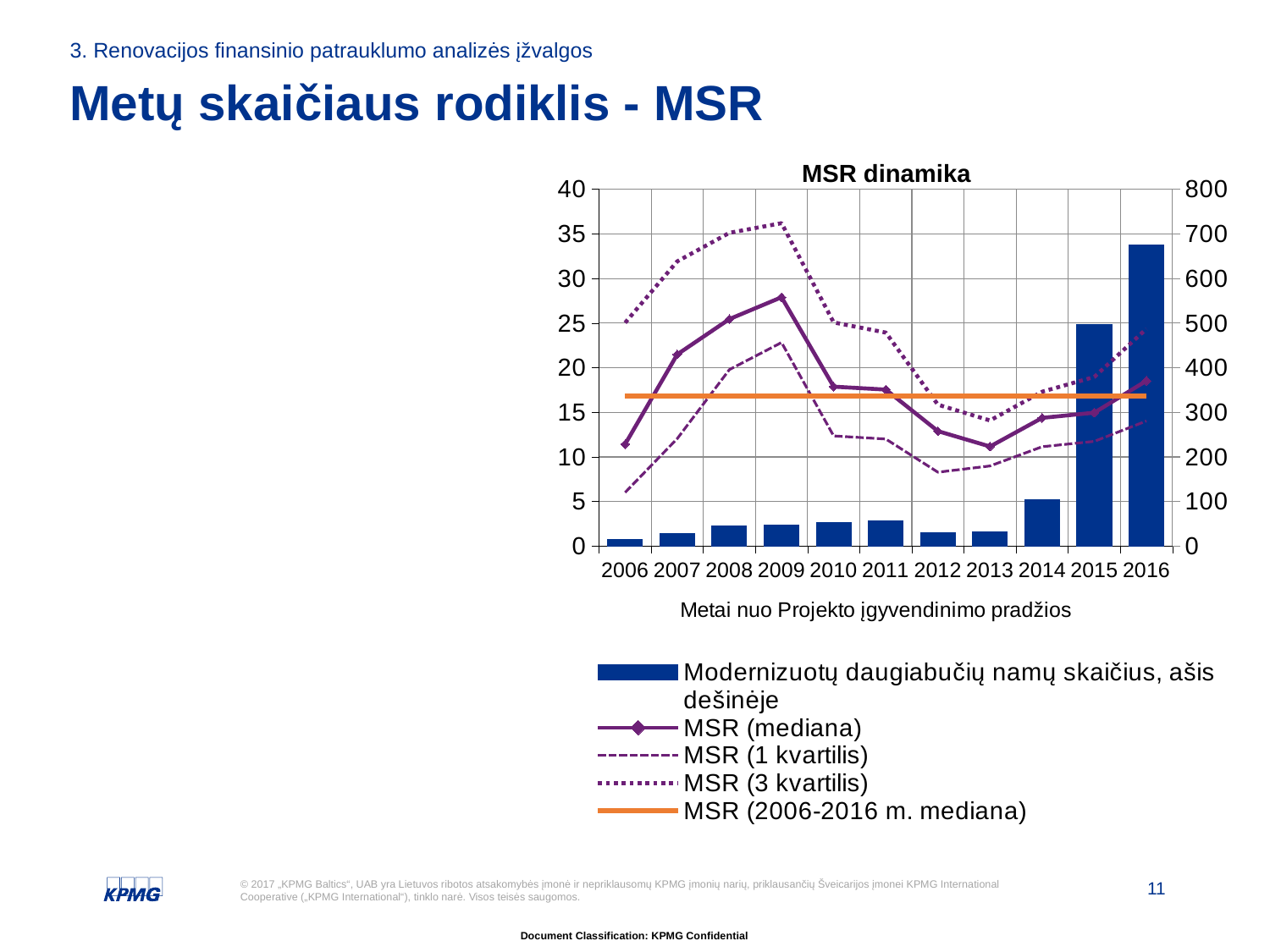
How many series does the legend of the MSR dinamika chart list? 5 Is the MSR (1 kvartilis) value for 2006 greater or less than 10? less In which year is the bar for Modernizuotų daugiabučių namų skaičius the highest? 2016 Which year has the larger MSR (mediana) value, 2006 or 2016? 2016 What is the title of the chart? MSR dinamika What kind of chart is shown on the slide? A combined bar and line chart Is the MSR (mediana) value for 2009 greater or less than 25? greater In which year is the bar for Modernizuotų daugiabučių namų skaičius the lowest? 2006 Is the bar value for Modernizuotų daugiabučių namų skaičius in 2016 greater or less than 600 on the right axis? greater In which year does the MSR (mediana) line reach its lowest value? 2013 In which year does the MSR (mediana) line reach its highest value? 2009 How many years are shown on the x axis of the MSR dinamika chart? 11